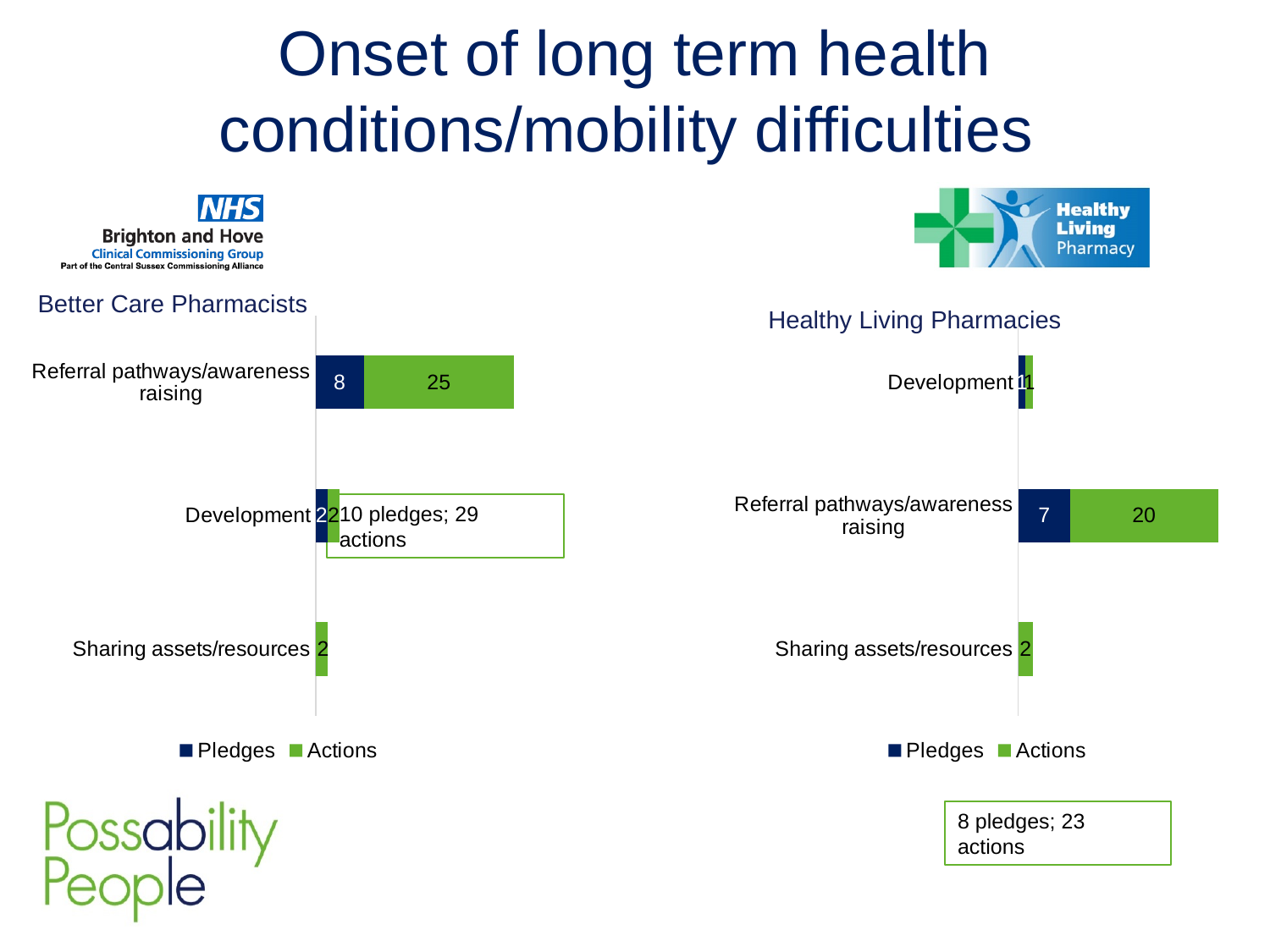
What kind of chart is the Healthy Living Pharmacies chart? Stacked bar chart How many categories are shown in the Healthy Living Pharmacies chart? 3 How many series does the legend of the Better Care Pharmacists chart list? 2 In the Healthy Living Pharmacies chart, how many Pledges are shown for Referral pathways/awareness raising? 7 In the Better Care Pharmacists chart, how many Actions are shown for Referral pathways/awareness raising? 25 In the Better Care Pharmacists chart, what is the total of the stacked bar for Referral pathways/awareness raising? 33 In the Better Care Pharmacists chart, how many Pledges are shown for Referral pathways/awareness raising? 8 In the Healthy Living Pharmacies chart, which category has the highest total? Referral pathways/awareness raising In the Better Care Pharmacists chart, which is larger for Referral pathways/awareness raising: Pledges or Actions? Actions In the Healthy Living Pharmacies chart, what is the total of the stacked bar for Referral pathways/awareness raising? 27 In the Healthy Living Pharmacies chart, how many Actions are shown for Referral pathways/awareness raising? 20 What is the difference between the Actions for Referral pathways/awareness raising in the Better Care Pharmacists chart and in the Healthy Living Pharmacies chart? 5